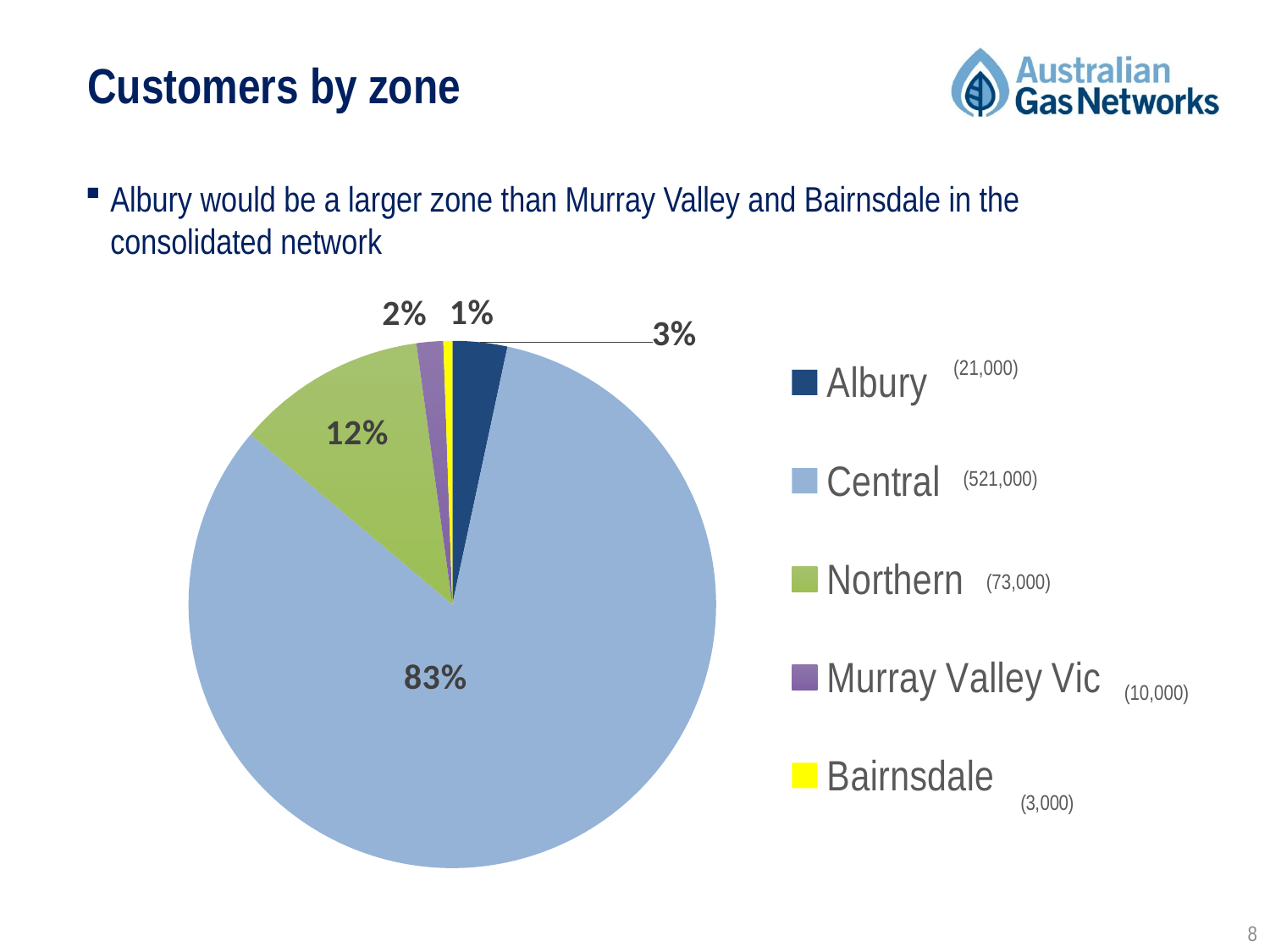
What share of customers does the Northern zone account for? 12% How many customers does the legend show for the Central zone? 521,000 Which zone has the larger share of customers, Albury or Murray Valley Vic? Albury What share of customers does the Bairnsdale zone account for? 1% Which zone has the largest share of customers? Central What is the difference in percentage points between the Central and Northern shares? 71 Which zone has the smallest share of customers? Bairnsdale What share of customers does the Central zone account for? 83% How many customers does the legend show for Murray Valley Vic? 10,000 How many zones are shown in the pie chart? 5 What kind of chart is shown on the slide? pie chart